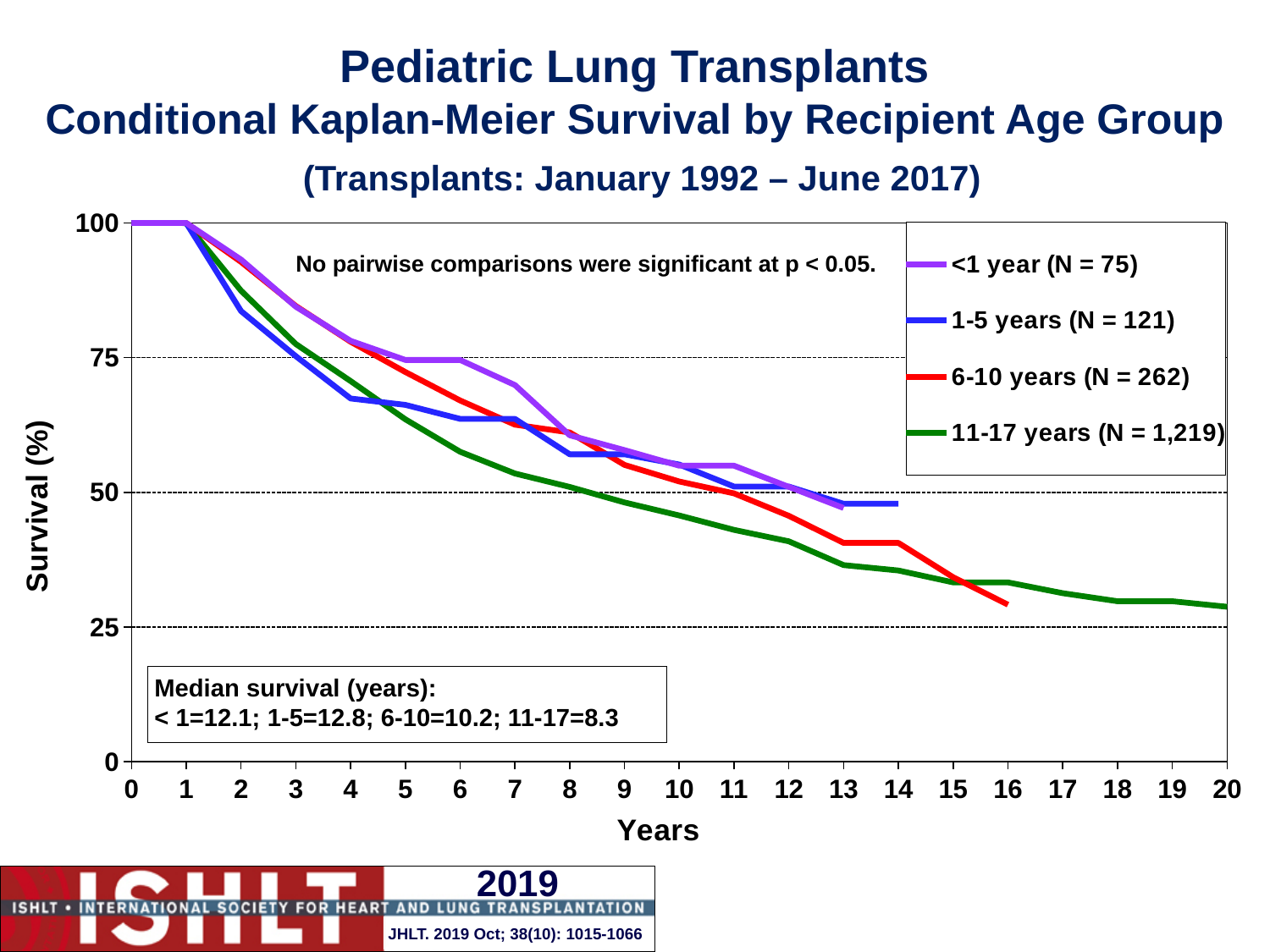
What is the N for the 11-17 years recipient age group shown in the legend? 1,219 What is the median survival in years for the 1-5 years age group? 12.8 Which recipient age group has the highest median survival? 1-5 years Do the survival curves rise or fall as years increase along the x axis? fall At 10 years, which group has higher survival: 6-10 years or 11-17 years? 6-10 years How many series does the legend list? 4 What kind of chart is shown on the slide? line chart Is the survival value for the 11-17 years group at 20 years greater or less than 50? less What is the difference in median survival (years) between the 1-5 years group and the 11-17 years group? 4.5 What is the median survival in years for the 11-17 years age group? 8.3 What is the N for the 6-10 years recipient age group shown in the legend? 262 Which recipient age group has the lowest median survival? 11-17 years